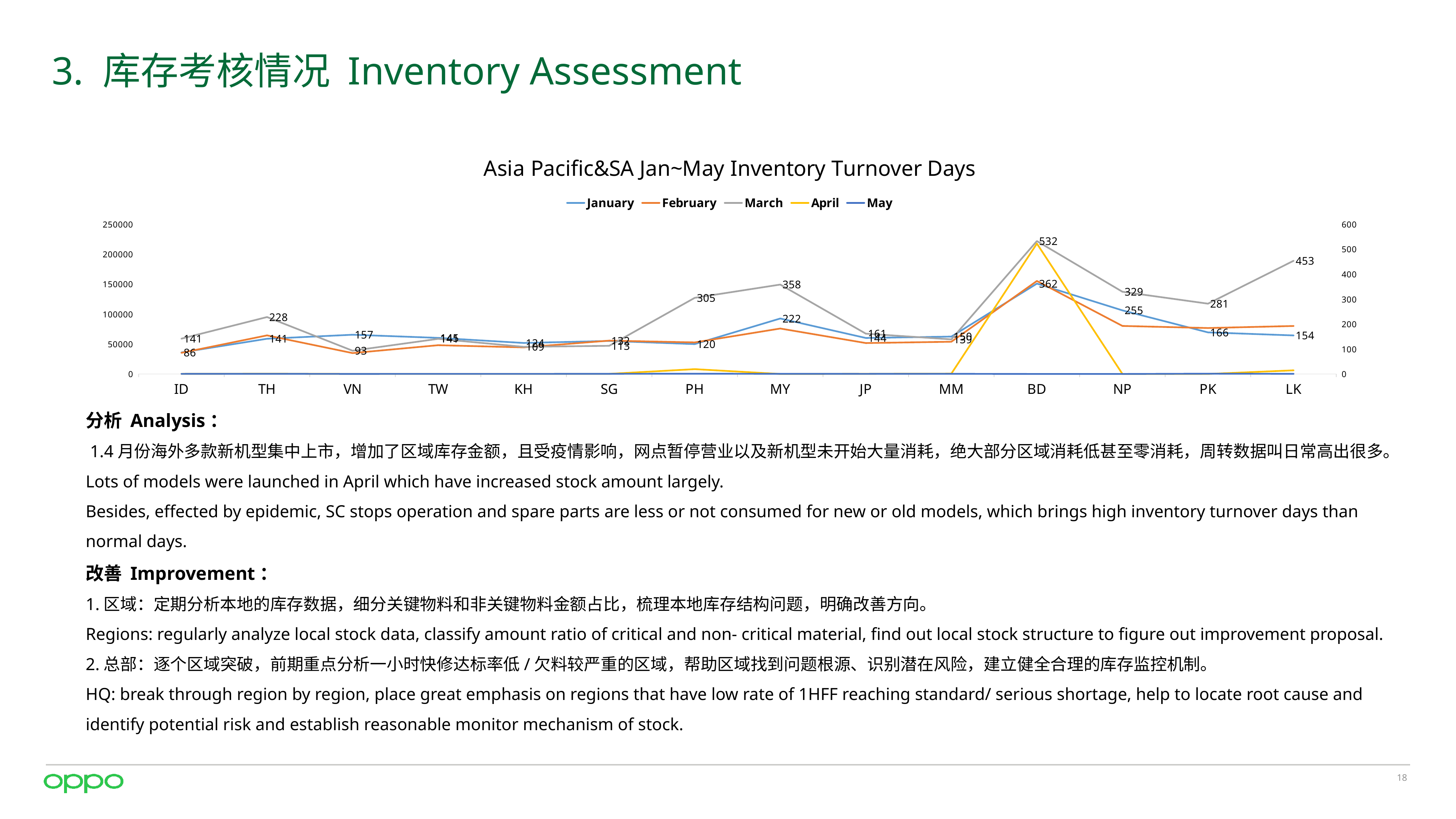
How many series does the legend list? 5 What is the difference between the March values for BD and LK? 79 What is the title of the chart? Asia Pacific&SA Jan~May Inventory Turnover Days What kind of chart is shown on the slide? line chart Which has the larger March value, PH or MY? MY Which region has the highest March value? BD What is the March value for LK? 453 How many regions are shown along the x axis? 14 Does the March line rise or fall from BD to NP? fall Which region has the lowest March value? VN What is the March inventory turnover days value for BD? 532 What is the March value for TH? 228